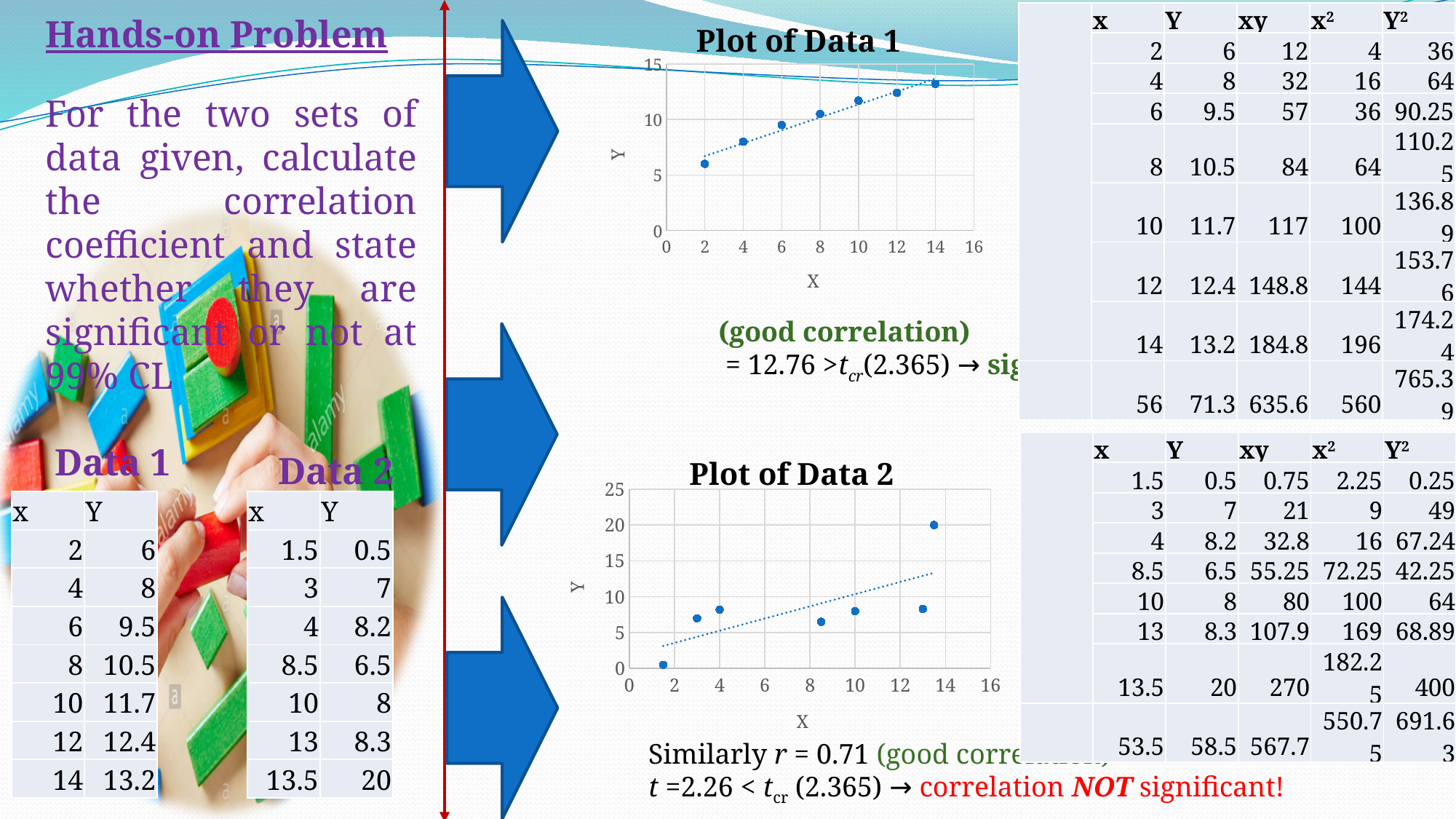
In "Plot of Data 2", which X value has the lowest Y value? 1.5 What is the highest tick value shown on the Y axis of "Plot of Data 2"? 25 In "Plot of Data 2", is the Y value at X = 13.5 greater or less than 15? greater In "Plot of Data 1", is the Y value at X = 2 greater or less than 5? greater In "Plot of Data 2", which has the larger Y value: the point at X = 4 or the point at X = 8.5? X = 4 In "Plot of Data 2", what is the Y value at X = 13.5? 20 In "Plot of Data 1", which X value has the highest Y value? 14 In "Plot of Data 1", what is the difference between the Y value at X = 14 and the Y value at X = 2? 7.2 How many data points are plotted in "Plot of Data 2"? 7 What kind of chart is "Plot of Data 1"? scatter chart In "Plot of Data 1", what is the Y value at X = 10? 11.7 In "Plot of Data 1", do the Y values rise or fall as X increases? rise